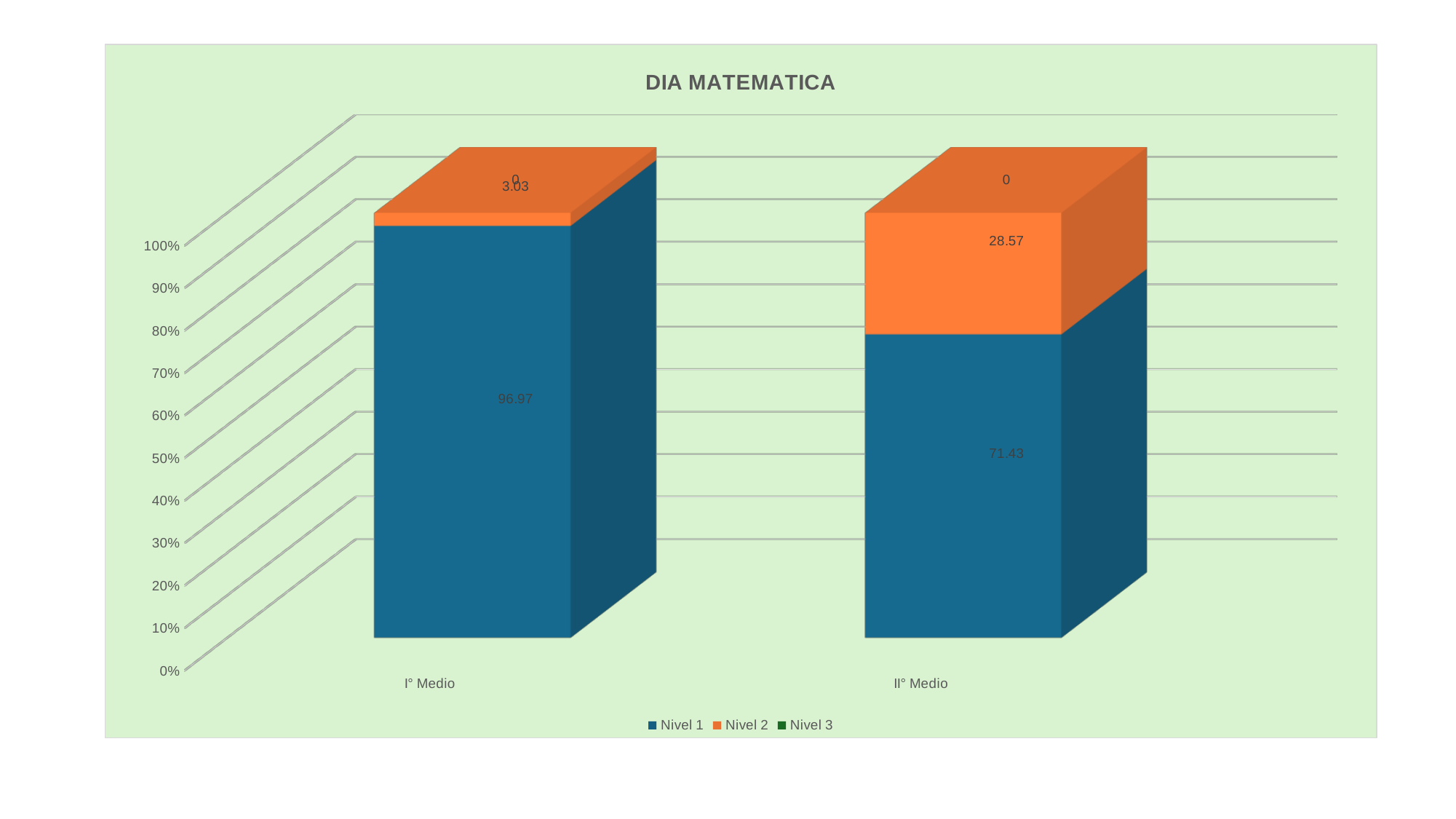
How many categories are shown on the x axis? 2 What is the value of Nivel 3 for II° Medio? 0 Which category has the higher Nivel 1 value, I° Medio or II° Medio? I° Medio What is the title of the chart? DIA MATEMATICA What is the difference between the Nivel 1 values for I° Medio and II° Medio? 25.54 What is the value of Nivel 1 for I° Medio? 96.97 How many series does the legend list? 3 What is the value of Nivel 1 for II° Medio? 71.43 What is the value of Nivel 2 for II° Medio? 28.57 What kind of chart is shown on the slide? Stacked bar chart What is the value of Nivel 2 for I° Medio? 3.03 Which category has the highest Nivel 2 value? II° Medio